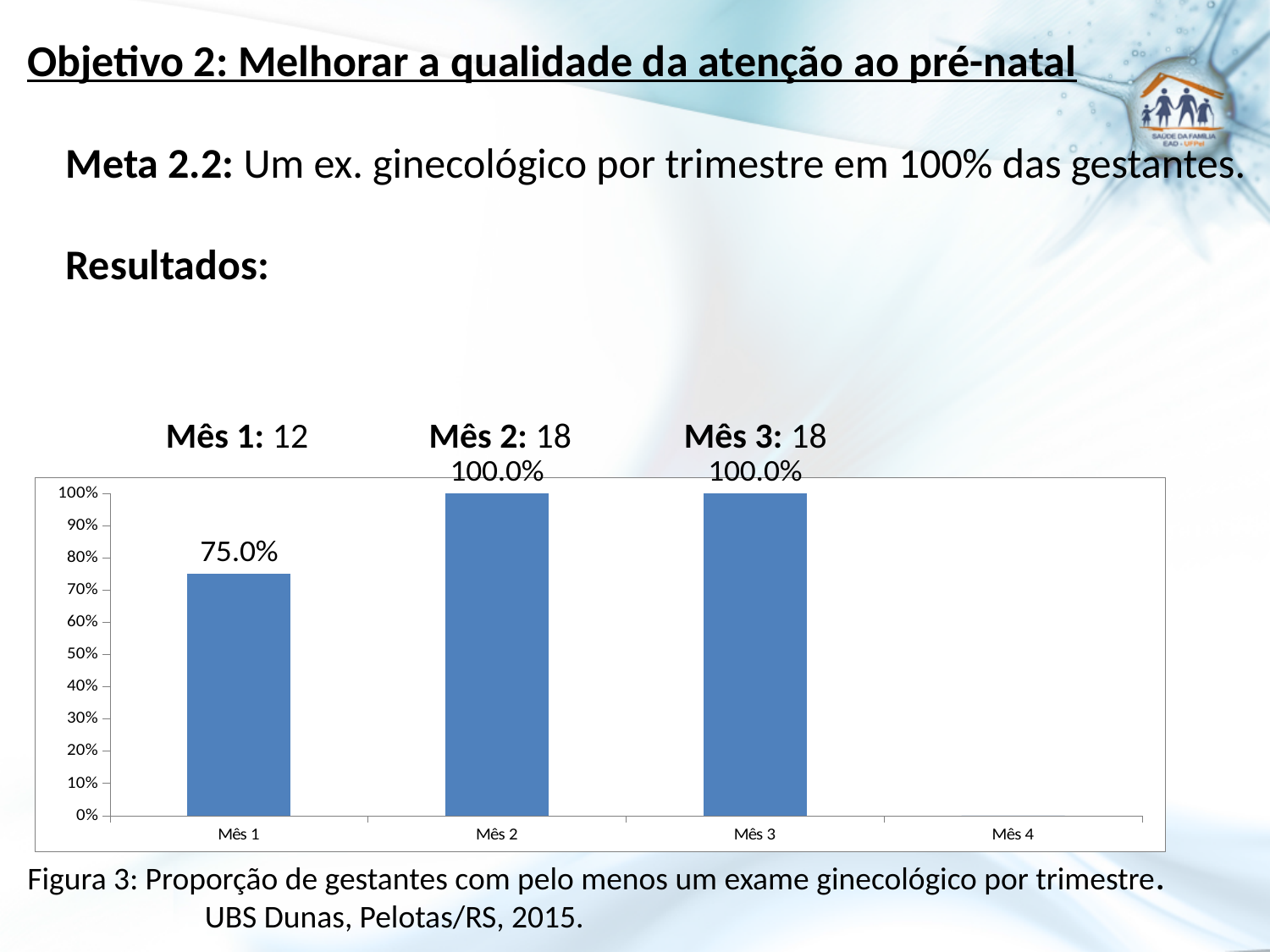
Is the value for Mês 1 greater or less than 80%? less How many month categories are shown on the x axis? 4 What kind of chart is shown on the slide? bar chart What colour are the bars in the chart? blue What is the highest value reached by any bar in the chart? 100.0% What is the value shown for Mês 2? 100.0% What is the difference between the values for Mês 2 and Mês 1? 25.0% Does the value rise or fall from Mês 1 to Mês 2? rise What is the value shown for Mês 3? 100.0% What is the value shown for Mês 1? 75.0% Which is larger, the value for Mês 1 or the value for Mês 3? Mês 3